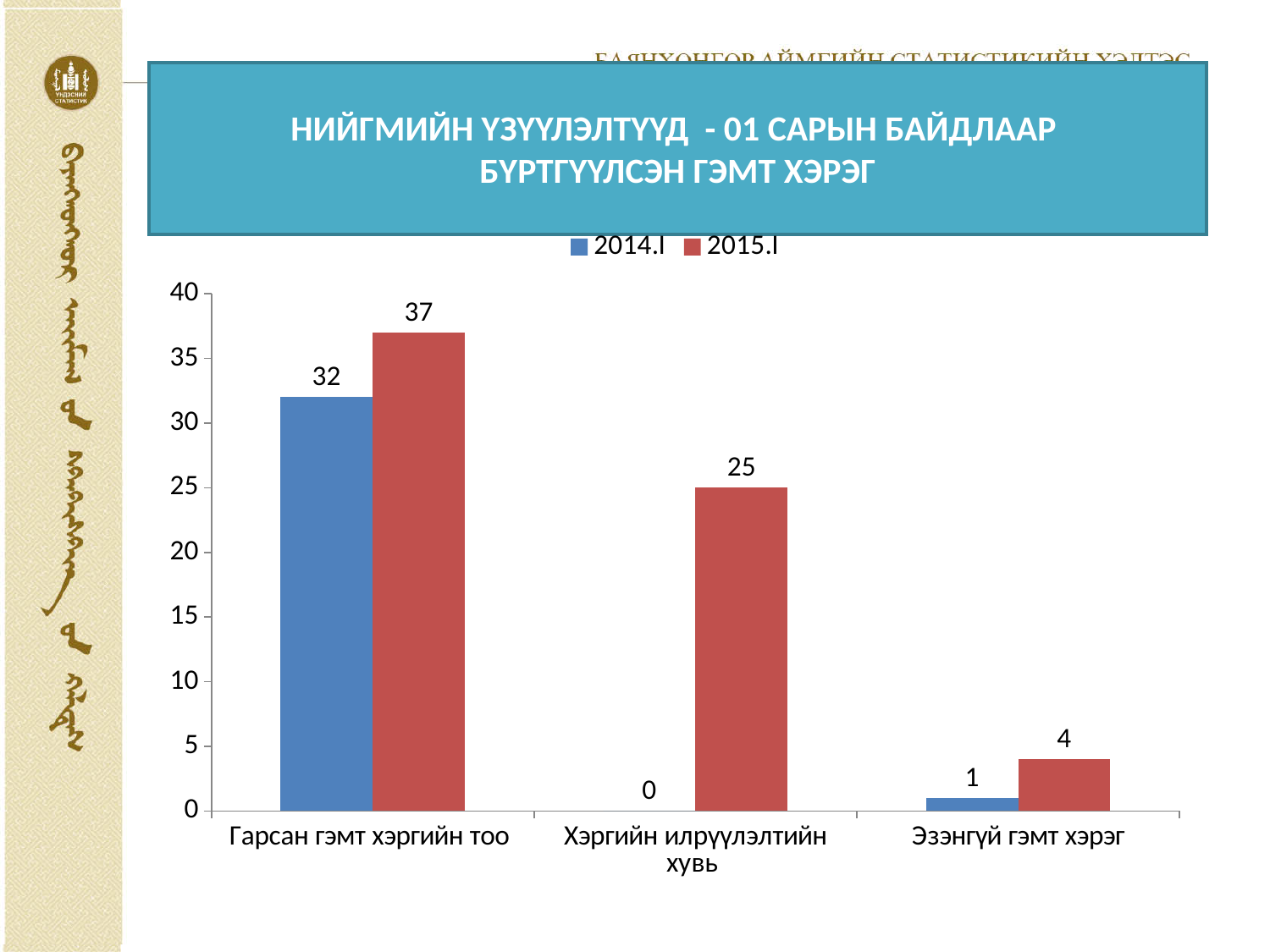
Which category has the highest value for the 2015.I series? Гарсан гэмт хэргийн тоо How many series does the legend list? 2 What is the value for 2014.I in the category Эзэнгүй гэмт хэрэг? 1 What is the value for 2015.I in the category Гарсан гэмт хэргийн тоо? 37 What is the value for 2015.I in the category Хэргийн илрүүлэлтийн хувь? 25 What is the value for 2014.I in the category Гарсан гэмт хэргийн тоо? 32 What kind of chart is shown on the slide? Bar chart Which category has the lowest value for the 2014.I series? Хэргийн илрүүлэлтийн хувь How many categories are shown on the x axis? 3 What is the value for 2015.I in the category Эзэнгүй гэмт хэрэг? 4 Which is larger for Эзэнгүй гэмт хэрэг: the 2014.I value or the 2015.I value? 2015.I What is the difference between the 2015.I and 2014.I values for Гарсан гэмт хэргийн тоо? 5